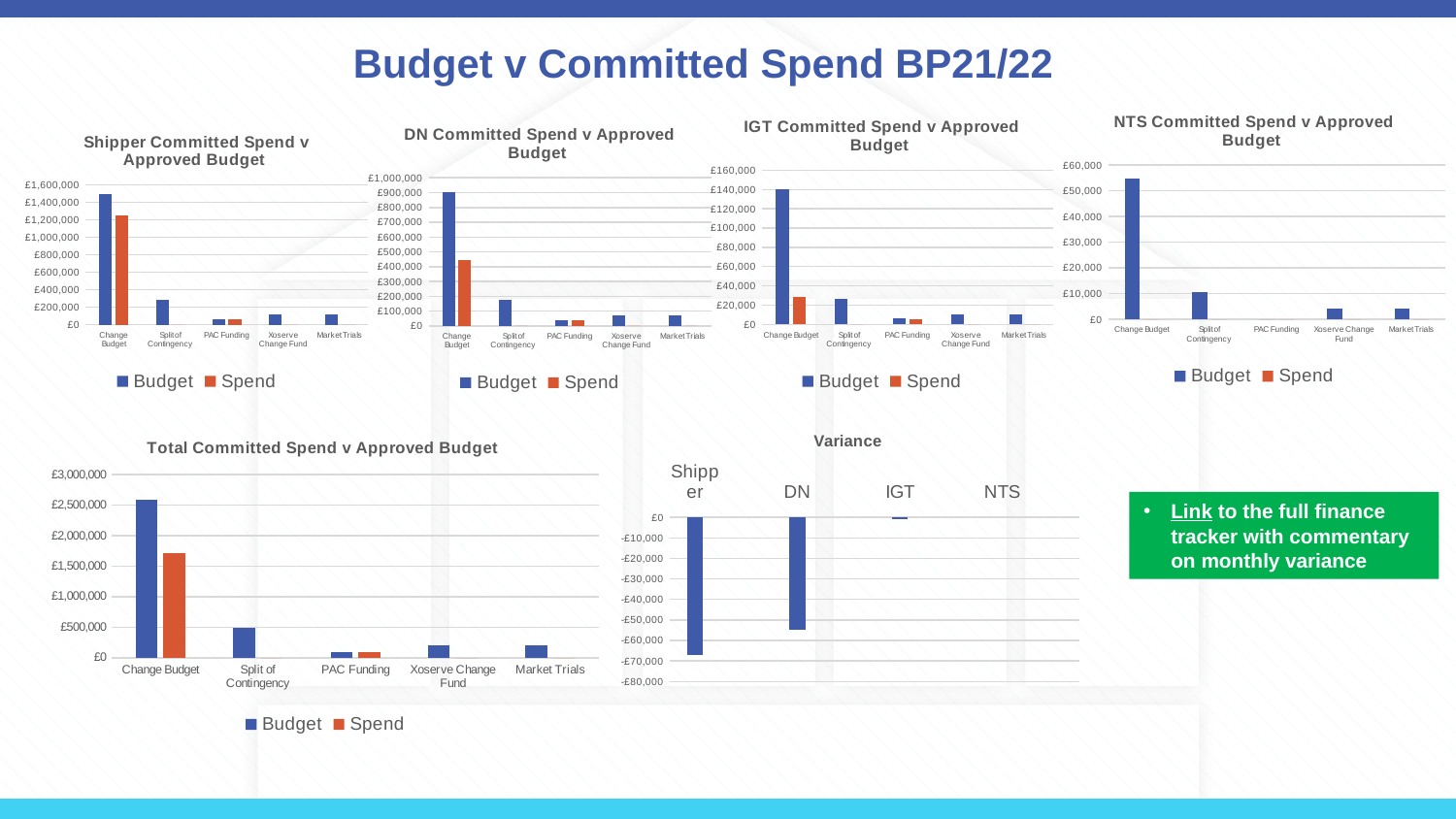
In the 'Variance' chart, which category has the lowest (most negative) value? Shipper In the 'NTS Committed Spend v Approved Budget' chart, is the Budget value for Change Budget greater or less than £50,000? greater In the 'Total Committed Spend v Approved Budget' chart, is the Spend value for Change Budget greater or less than £1,500,000? greater What is the title of the chart in the top right corner of the slide? NTS Committed Spend v Approved Budget What kind of chart is the 'Total Committed Spend v Approved Budget' chart? Bar chart In the 'Shipper Committed Spend v Approved Budget' chart, is the Budget value for Change Budget greater or less than £1,400,000? greater How many categories are shown in the 'Variance' chart? 4 In the 'Shipper Committed Spend v Approved Budget' chart, how many categories are shown on the x axis? 5 In the 'DN Committed Spend v Approved Budget' chart, how many series does the legend list? 2 In the 'IGT Committed Spend v Approved Budget' chart, for Change Budget, which is larger: Budget or Spend? Budget In the 'Total Committed Spend v Approved Budget' chart, which category has the highest Budget value? Change Budget